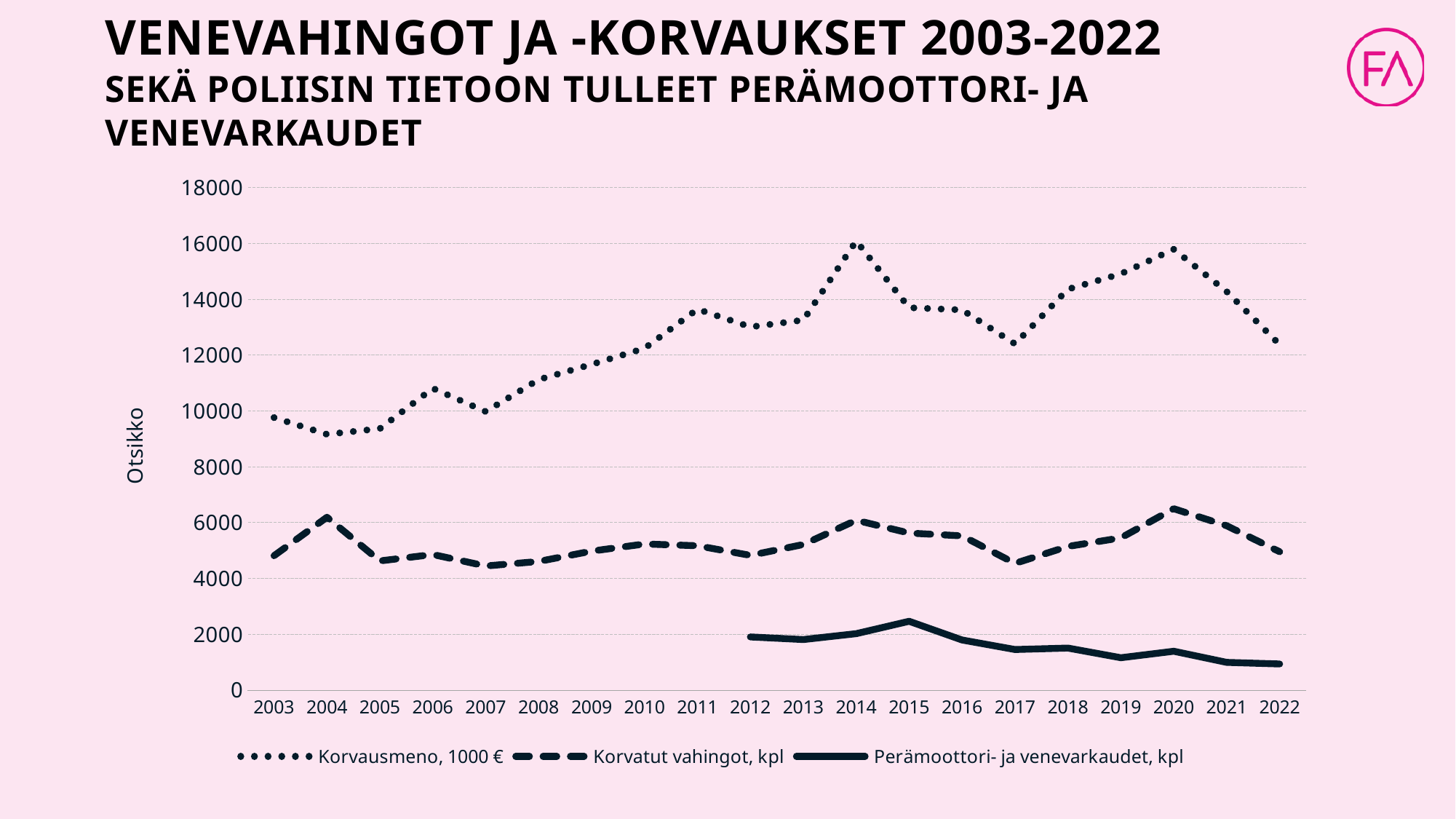
Is the value of Perämoottori- ja venevarkaudet, kpl in 2022 greater or less than 2000? less Does the Perämoottori- ja venevarkaudet, kpl series rise or fall from 2015 to 2022? fall In which year does the Perämoottori- ja venevarkaudet, kpl series reach its highest value? 2015 Which is larger for Korvausmeno, 1000 €: the value in 2014 or the value in 2003? 2014 Is the value of Korvatut vahingot, kpl in 2007 greater or less than 6000? less Is the value of Korvausmeno, 1000 € in 2014 greater or less than 14000? greater What kind of chart is shown on the slide? line chart How many years are shown on the x axis? 20 What is the label on the y axis? Otsikko In which year does the Perämoottori- ja venevarkaudet, kpl series begin? 2012 How many series does the legend list? 3